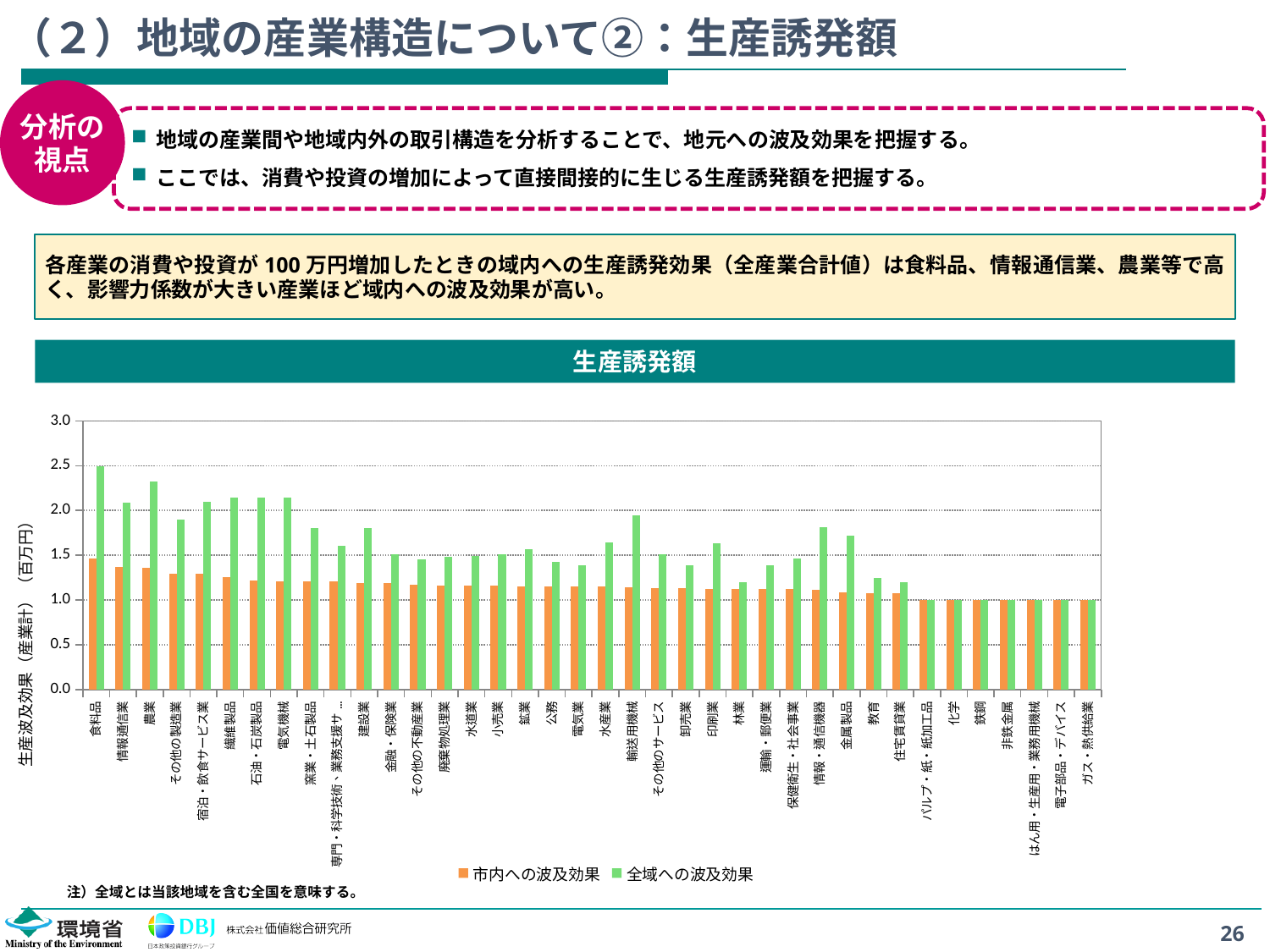
Which is larger, the 全域への波及効果 value for 食料品 or for 農業? 食料品 Which industry has the highest value for 市内への波及効果? 食料品 Is the 全域への波及効果 value for 輸送用機械 greater or less than 1.5? greater Is the 全域への波及効果 value for 建設業 greater or less than 1.5? greater Do the 市内への波及効果 values generally rise or fall from left to right along the x axis? fall Is the 全域への波及効果 value for 食料品 greater or less than 2.0? greater How many industry categories are plotted along the x axis? 38 What kind of chart is shown on the slide? bar chart Which industry has the highest value for 全域への波及効果? 食料品 How many series does the chart legend list? 2 What is the title of the chart? 生産誘発額